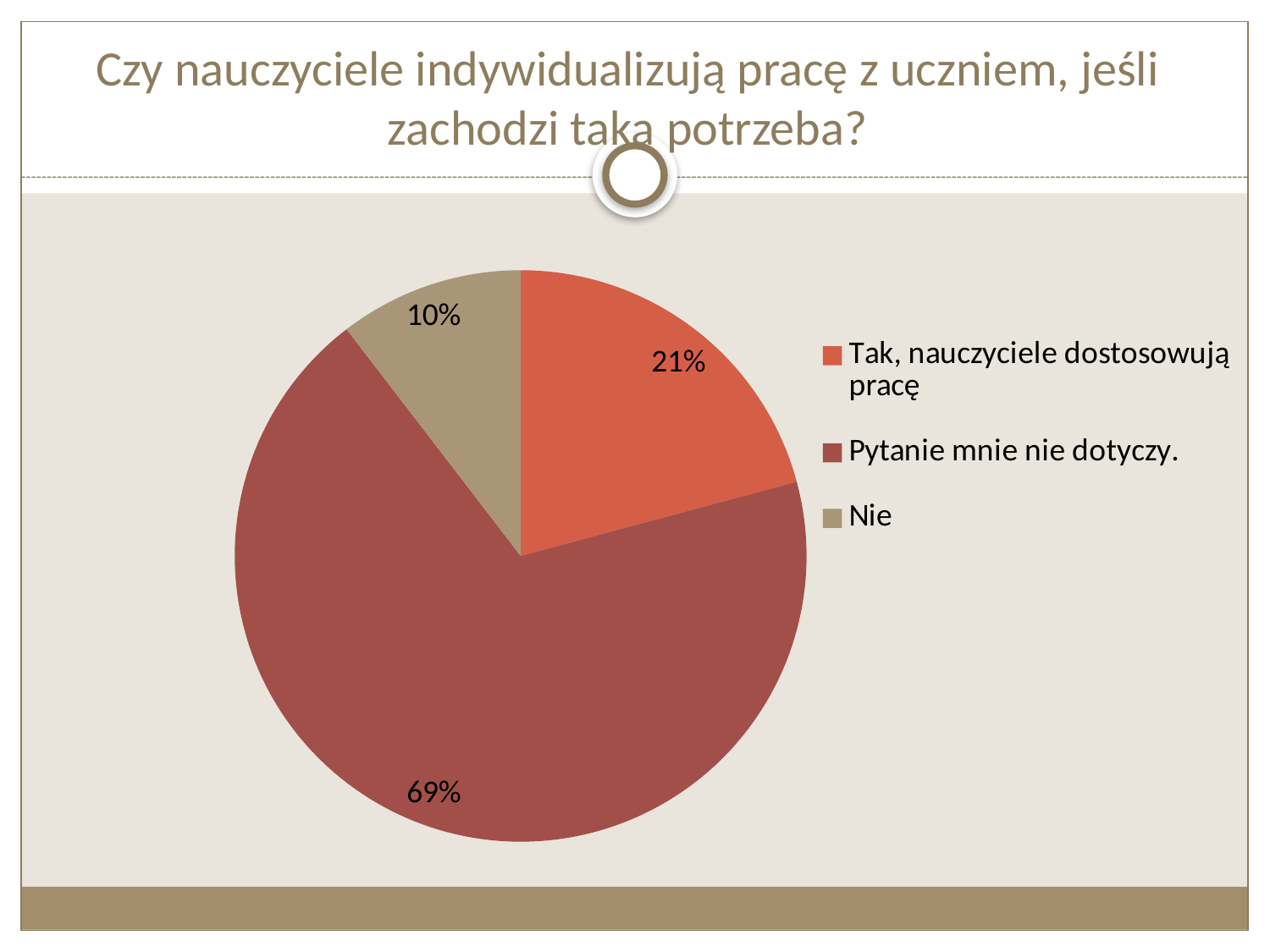
What is the difference in percentage points between "Tak, nauczyciele dostosowują pracę" and "Nie"? 11 What share of the pie does "Nie" have? 10% What kind of chart is shown on the slide? pie chart How many entries does the legend list? 3 Which category has the smallest slice of the pie? Nie What colour is the slice for "Nie"? beige/tan Which is larger: the slice for "Tak, nauczyciele dostosowują pracę" or the slice for "Nie"? Tak, nauczyciele dostosowują pracę What is the difference in percentage points between "Pytanie mnie nie dotyczy." and "Tak, nauczyciele dostosowują pracę"? 48 How many slices does the pie chart have? 3 What share of the pie does "Tak, nauczyciele dostosowują pracę" have? 21% What share of the pie does "Pytanie mnie nie dotyczy." have? 69% Which category has the largest slice of the pie? Pytanie mnie nie dotyczy.